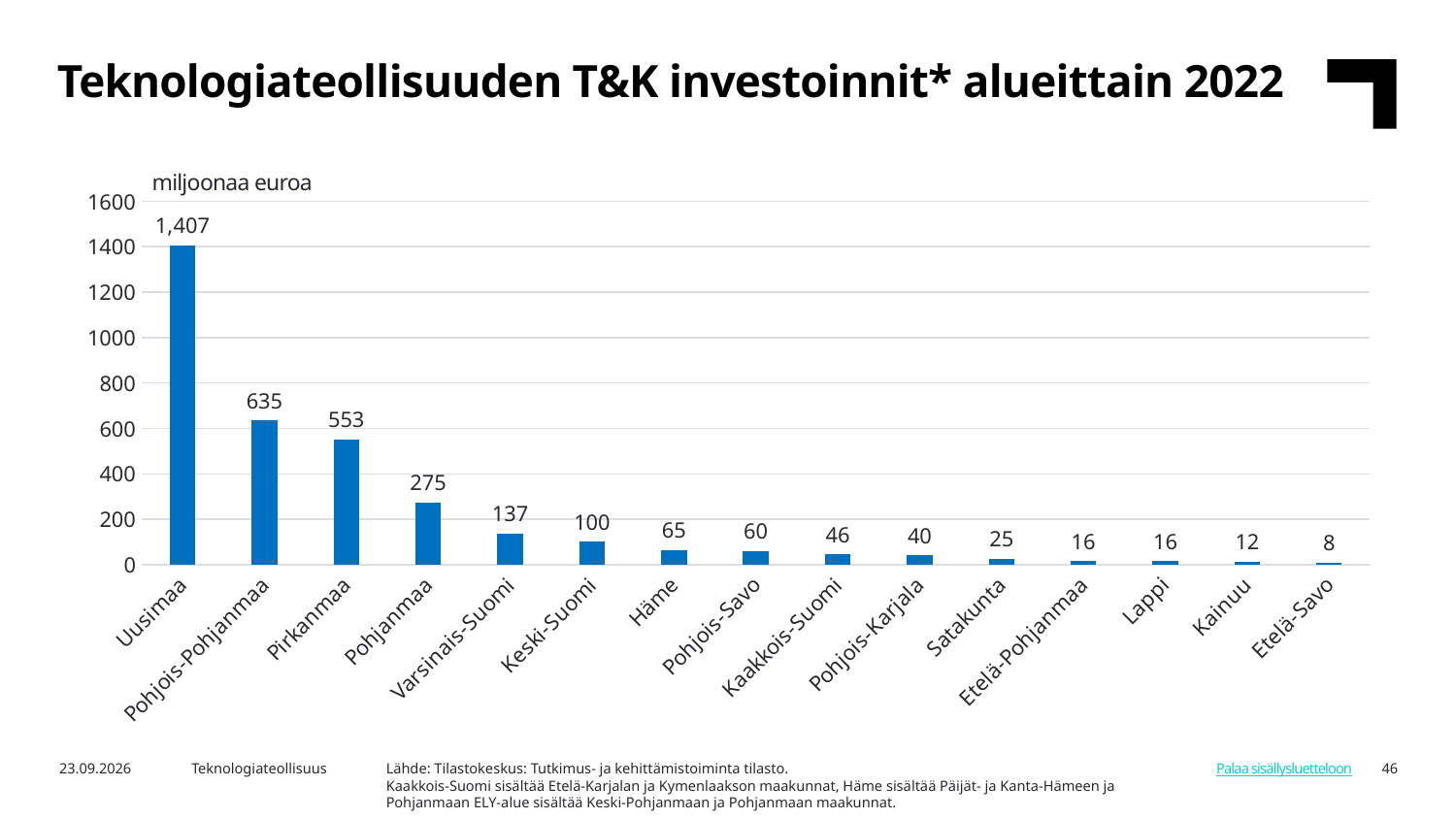
How many regions are shown in the chart? 15 What is the difference between the values for Pohjois-Pohjanmaa and Pirkanmaa? 82 Which region has the highest value? Uusimaa Which region has the lowest value? Etelä-Savo Which is larger, the value for Pohjanmaa or the value for Keski-Suomi? Pohjanmaa What is the value for Uusimaa? 1,407 What is the value for Pirkanmaa? 553 What kind of chart is shown on the slide? bar chart What is the value for Varsinais-Suomi? 137 What is the value for Satakunta? 25 Is the value for Pohjois-Pohjanmaa greater or less than 600? greater What unit is shown above the vertical axis of the chart? miljoonaa euroa